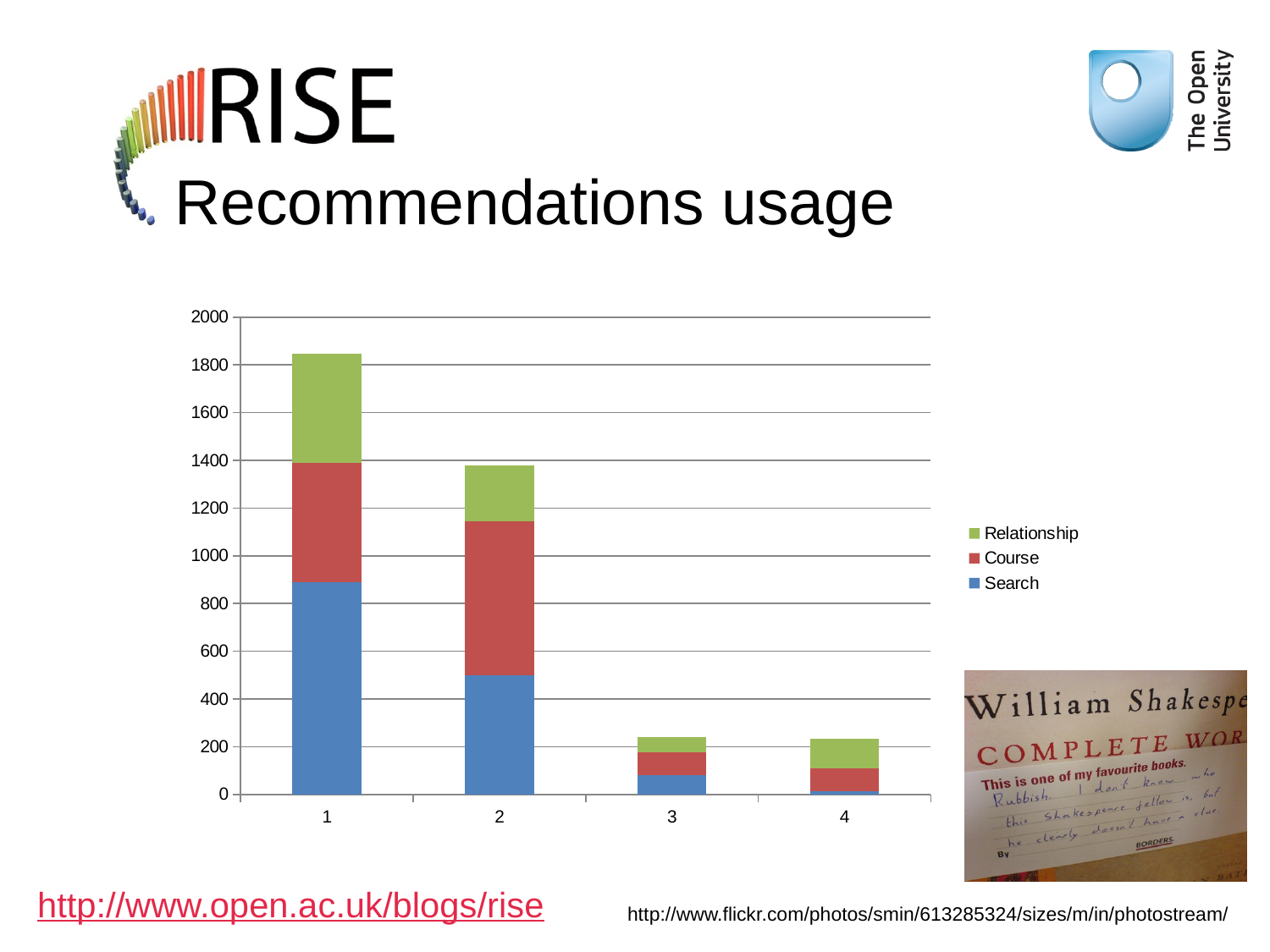
Is the Search value for category 1 greater or less than 800? greater Is the total of the stacked bar for category 3 greater or less than 400? less How many series does the chart's legend list? 3 Which series is shown in blue in the chart's legend? Search What kind of chart is shown on the slide? Stacked bar chart How many categories are shown on the x axis of the chart? 4 Which has the larger Search value, category 1 or category 2? 1 Do the stacked bar totals rise or fall from category 1 to category 4? fall Which category has the tallest stacked bar? 1 Which series makes up the largest part of the stacked bar for category 2? Course Is the total of the stacked bar for category 1 greater or less than 1800? greater